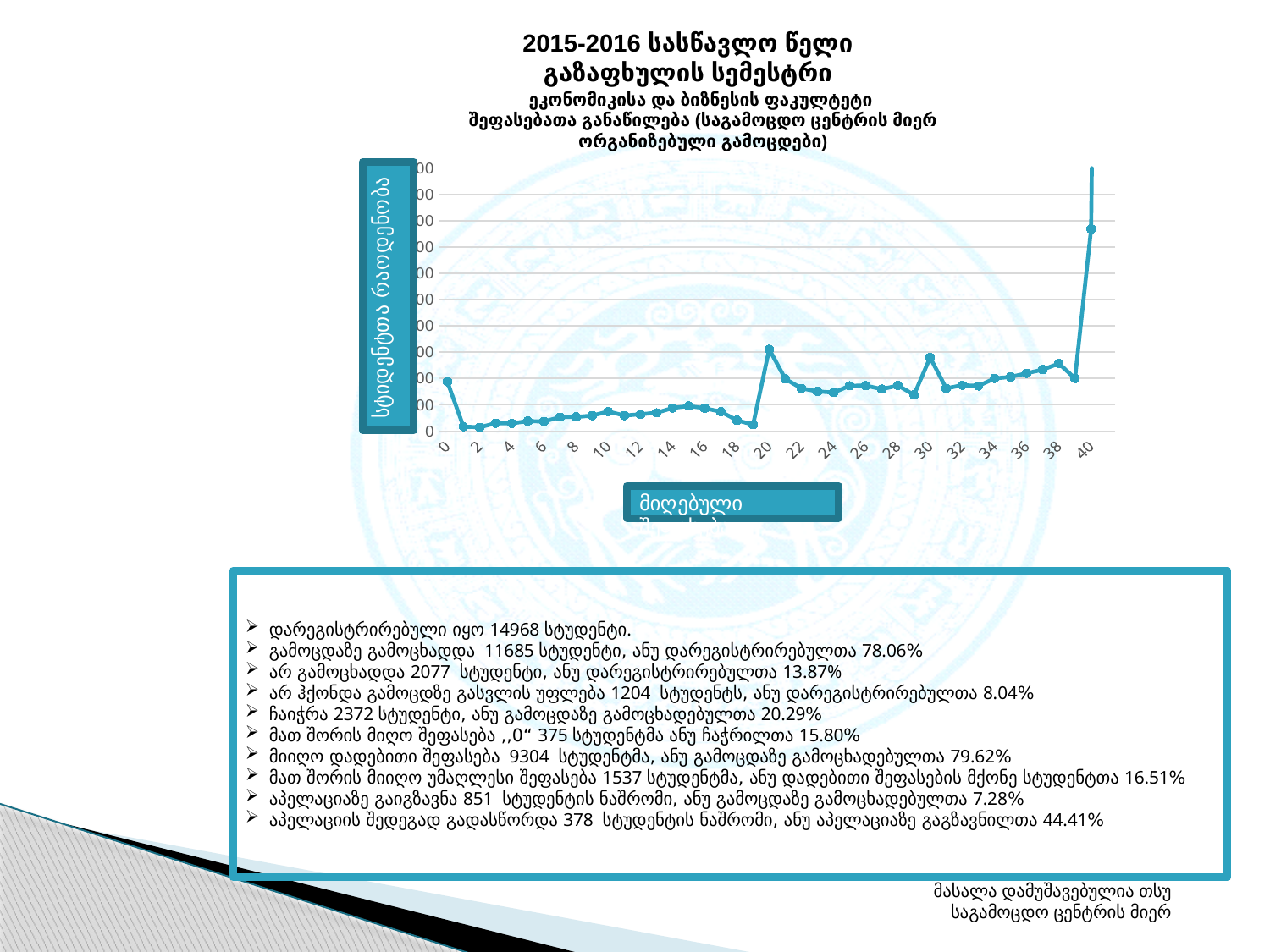
Which has the larger value, x = 40 or x = 38? 40 Do the values rise or fall between x = 20 and x = 23? fall Which has the larger value, x = 30 or x = 29? 30 What kind of chart is shown on the slide? line chart Do the values rise or fall between x = 33 and x = 38? rise Is the value at x = 20 larger or smaller than the value at x = 10? larger What is the largest value labelled on the x axis? 40 Do the values rise or fall between x = 38 and x = 40? rise What is the title of the vertical axis? სტუდენტთა რაოდენობა